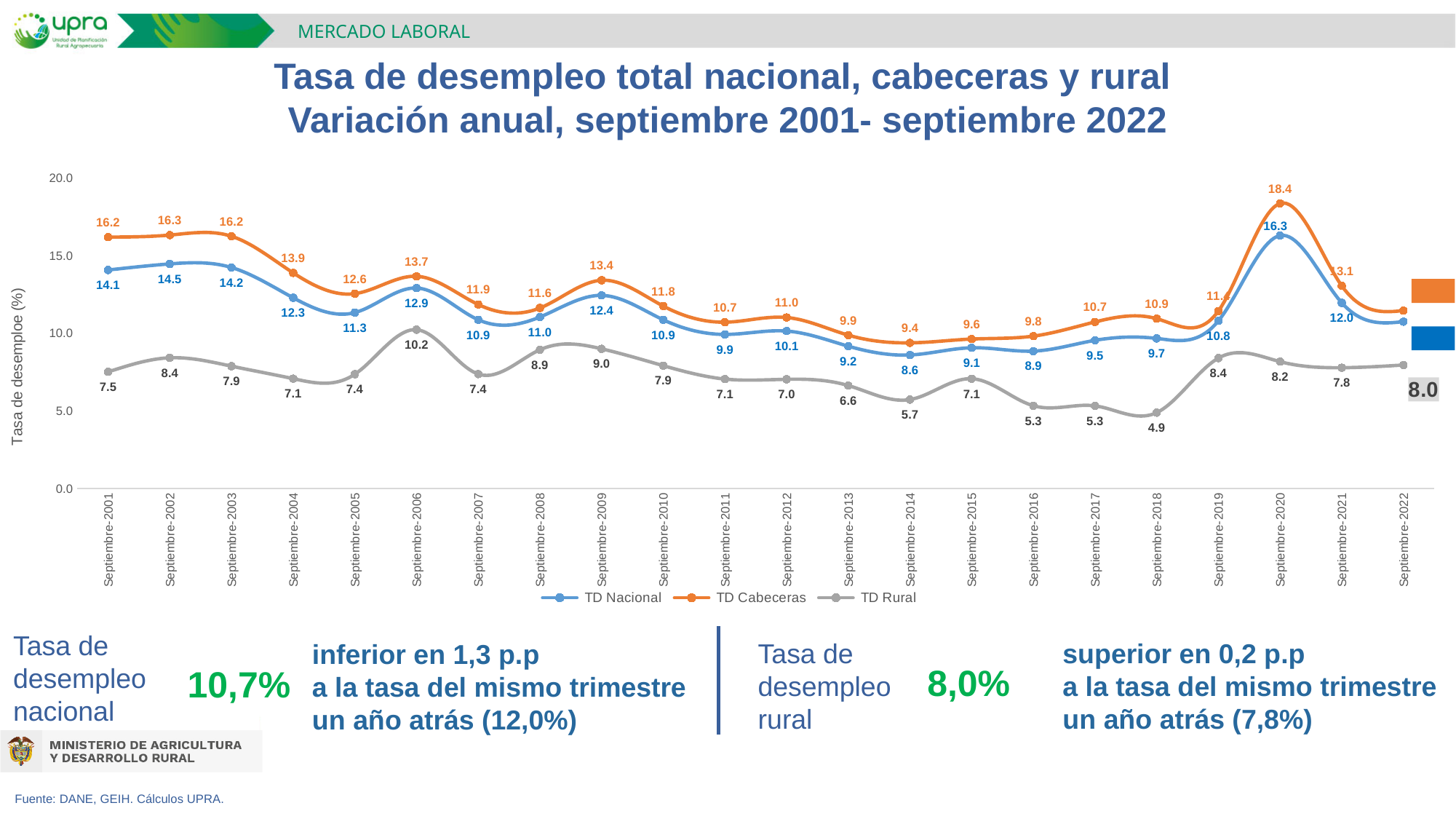
What is the label of the vertical axis? Tasa de desempleo (%) In which period does TD Nacional reach its highest value? Septiembre-2020 What is the value of TD Rural for Septiembre-2018? 4.9 How many time points are plotted along the x axis? 22 How many series does the legend list? 3 Which is larger for TD Rural: the value in Septiembre-2006 or in Septiembre-2009? Septiembre-2006 In which period does TD Rural reach its lowest value? Septiembre-2018 What is the value of TD Cabeceras for Septiembre-2020? 18.4 What kind of chart is shown on the slide? line chart What is the value of TD Nacional for Septiembre-2001? 14.1 What is the difference between TD Cabeceras and TD Nacional in Septiembre-2020? 2.1 Is the value of TD Rural for Septiembre-2014 greater or less than 10.0? less